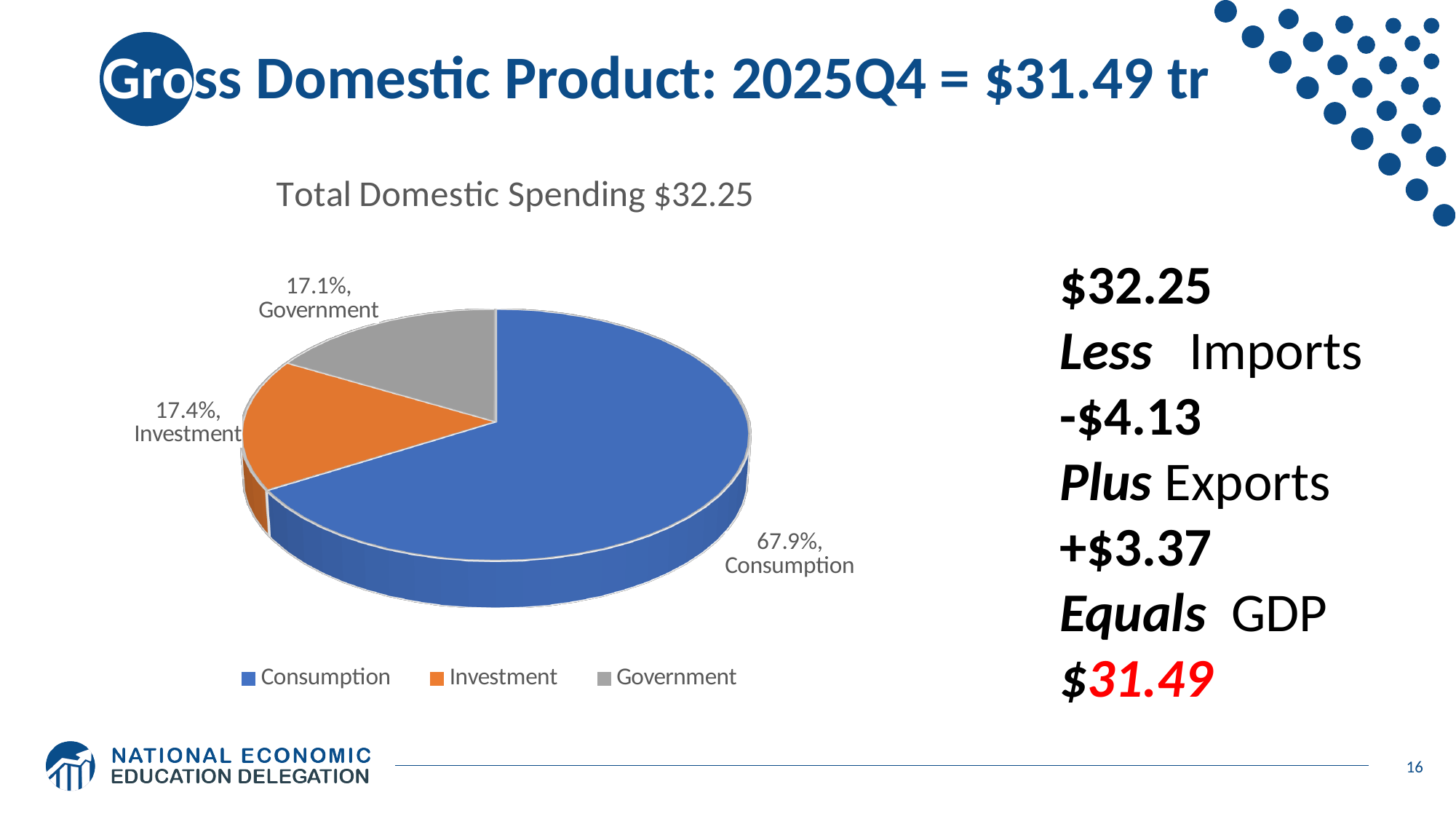
How many entries does the legend list? 3 Which category has the largest slice of the pie? Consumption What is the difference in percentage points between the Investment and Government shares? 0.3 Which colour represents Investment in the pie chart? orange What is the title of the chart? Total Domestic Spending $32.25 What share of the pie does Government account for? 17.1% What share of the pie does Investment account for? 17.4% How many slices does the pie chart have? 3 Which category has the smallest slice of the pie? Government What is the difference in percentage points between the Consumption and Investment shares? 50.5 What type of chart is shown on the slide? pie chart What share of the pie does Consumption account for? 67.9%